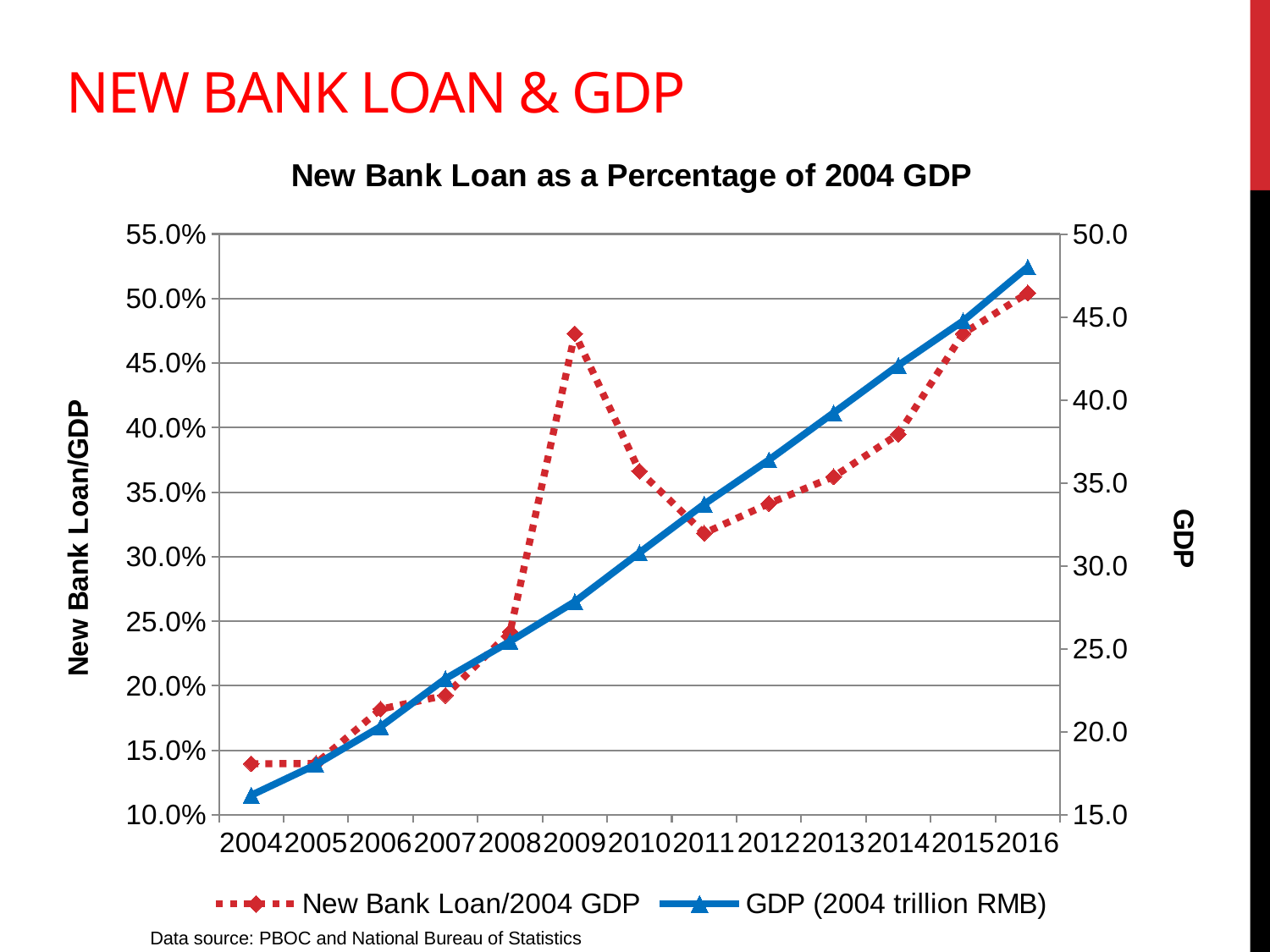
What is the title of the chart? New Bank Loan as a Percentage of 2004 GDP Is the value for GDP (2004 trillion RMB) in 2016 greater or less than 45.0? greater In which year is the GDP (2004 trillion RMB) series lowest? 2004 In which year is the New Bank Loan/2004 GDP series highest? 2016 How many series does the legend list? 2 What is the label of the right-hand vertical axis? GDP Is the value for New Bank Loan/2004 GDP in 2009 greater or less than 45.0%? greater Does the GDP (2004 trillion RMB) series rise or fall from 2004 to 2016? Rise Is the value for New Bank Loan/2004 GDP in 2011 greater or less than 35.0%? less What kind of chart is shown on the slide? Line chart How many years are plotted along the x axis? 13 In which year is the GDP (2004 trillion RMB) series highest? 2016